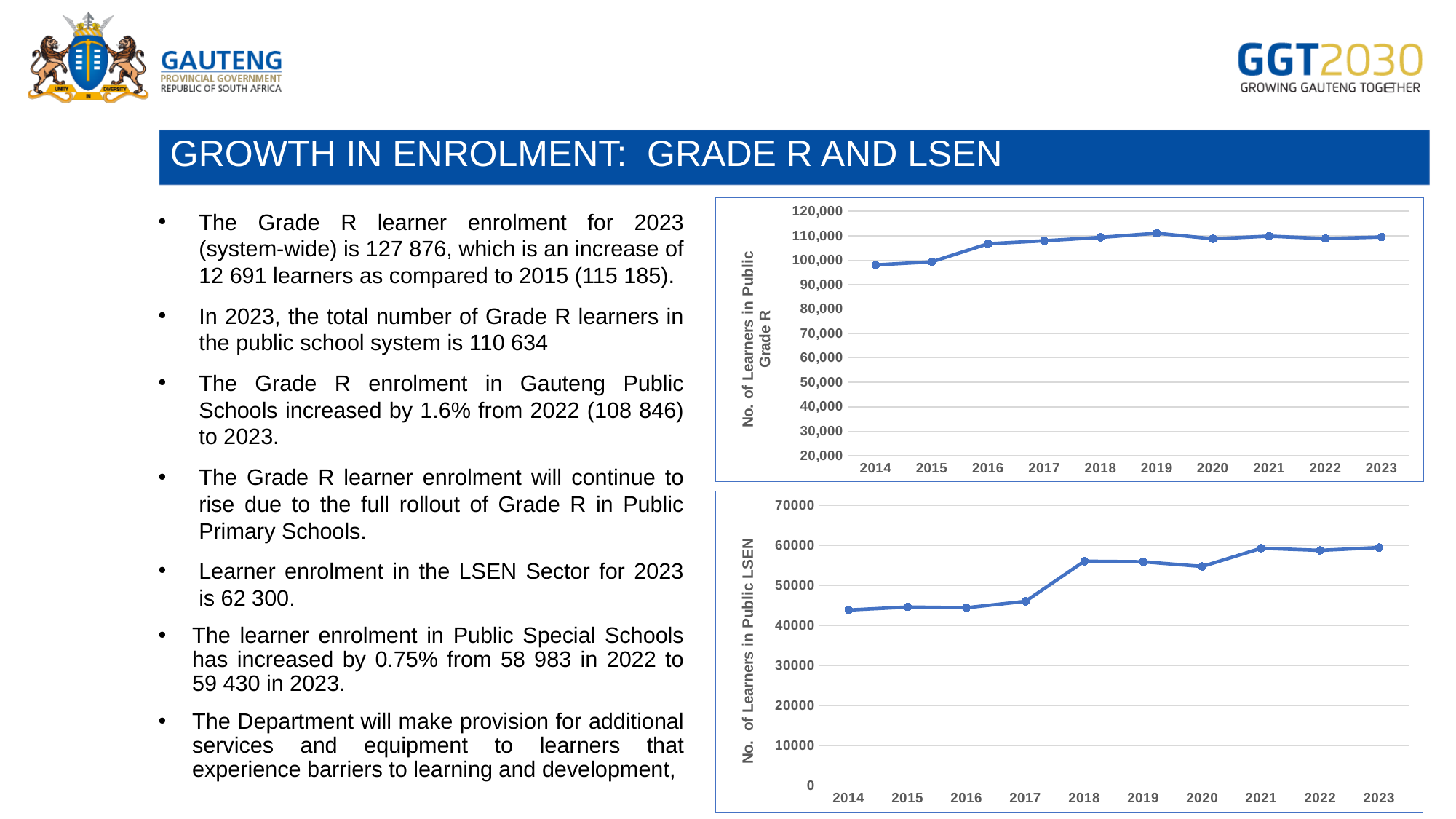
In the top chart (No. of Learners in Public Grade R), which year has the highest value? 2019 In the bottom chart (No. of Learners in Public LSEN), do the values generally rise or fall from 2014 to 2023? rise What kind of chart is the top chart (No. of Learners in Public Grade R)? line chart In the top chart (No. of Learners in Public Grade R), is the value for 2016 greater or less than 100,000? greater In the top chart (No. of Learners in Public Grade R), how many years are plotted on the x axis? 10 In the top chart (No. of Learners in Public Grade R), is the value for 2014 greater or less than 100,000? less What kind of chart is the bottom chart (No. of Learners in Public LSEN)? line chart In the bottom chart (No. of Learners in Public LSEN), is the value for 2018 greater or less than 50000? greater In the top chart (No. of Learners in Public Grade R), which year has the lowest value? 2014 In the bottom chart (No. of Learners in Public LSEN), how many data points are plotted? 10 In the bottom chart (No. of Learners in Public LSEN), which is larger, the value for 2017 or the value for 2018? 2018